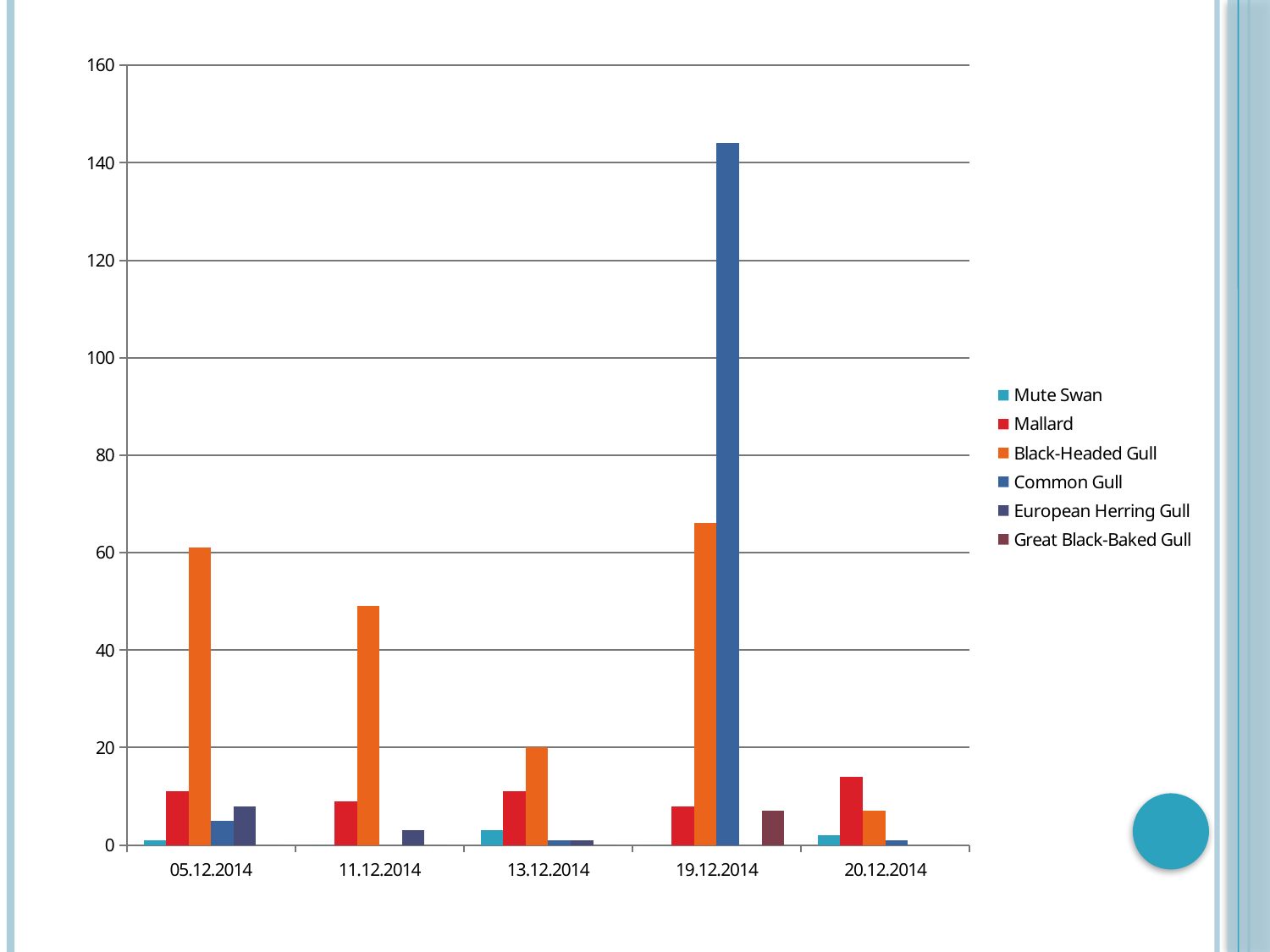
Is the value for Black-Headed Gull on 11.12.2014 greater or less than 40? greater Is the value for Common Gull on 19.12.2014 greater or less than 140? greater Which colour represents Black-Headed Gull in the legend? orange Which is larger on 20.12.2014, the Mallard value or the Black-Headed Gull value? Mallard On which date is the Mallard bar the highest? 20.12.2014 Which series has the tallest bar on 19.12.2014? Common Gull How many dates are shown along the x axis? 5 How many series does the legend list? 6 Which is larger, the Black-Headed Gull value on 05.12.2014 or on 11.12.2014? 05.12.2014 On which date is the Common Gull bar the highest? 19.12.2014 What kind of chart is shown on the slide? bar chart